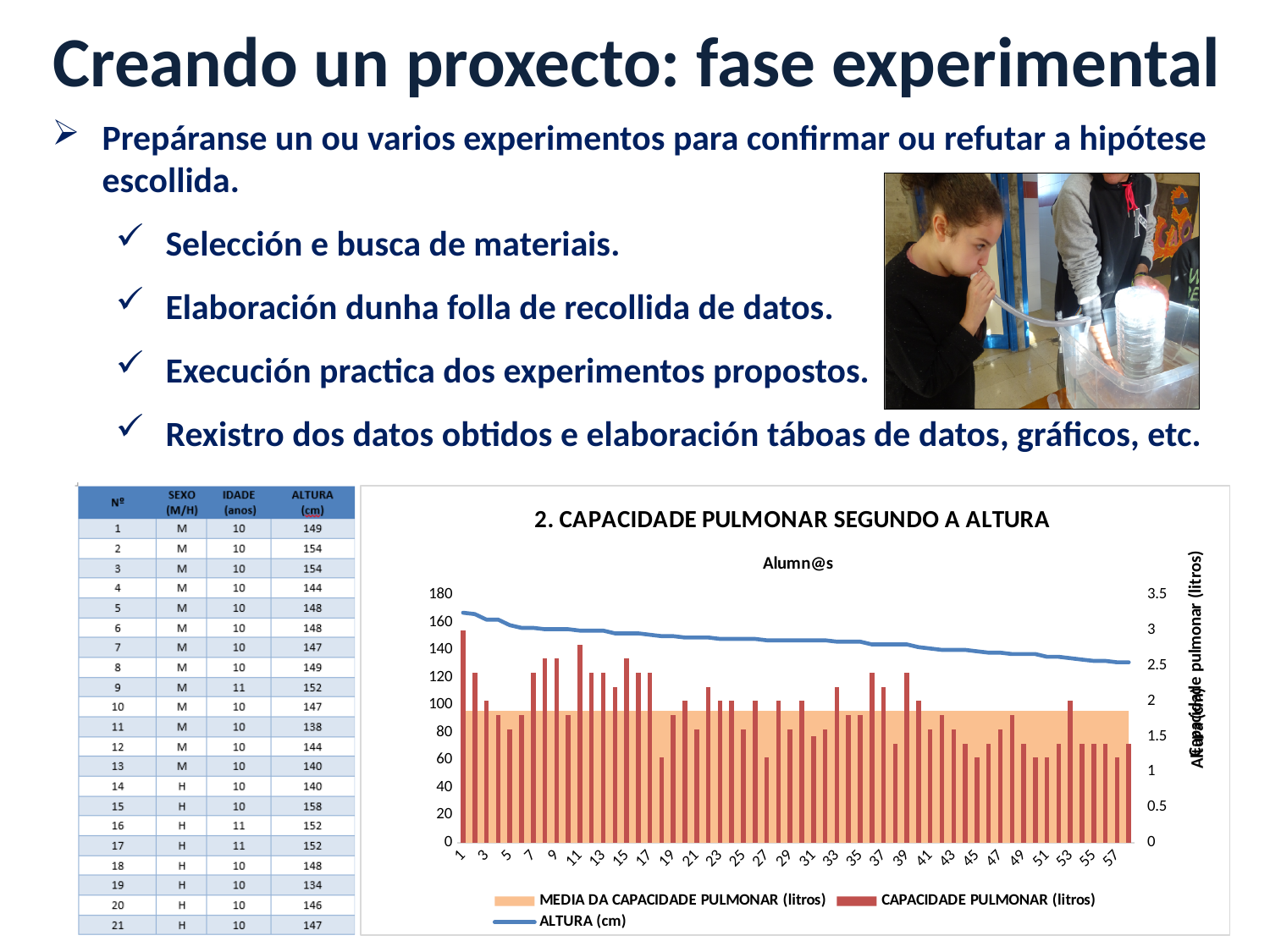
Which student has the larger ALTURA (cm) value, student 1 or student 57? Student 1 Is the ALTURA (cm) value for student 57 greater or less than 140? less Which series is drawn as a line in the chart? ALTURA (cm) What is the title of the chart on the slide? 2. CAPACIDADE PULMONAR SEGUNDO A ALTURA What kind of chart is shown on the slide? Combined area, bar and line chart Which student has the larger CAPACIDADE PULMONAR (litros) bar, student 1 or student 2? Student 1 How many series does the chart legend list? 3 Is the ALTURA (cm) value for student 1 greater or less than 160? greater What is the maximum value shown on the right vertical axis of the chart? 3.5 What is the maximum value shown on the left vertical axis of the chart? 180 Which student has the highest CAPACIDADE PULMONAR (litros) bar? 1 Does the ALTURA (cm) line rise or fall from left to right along the x axis? Fall